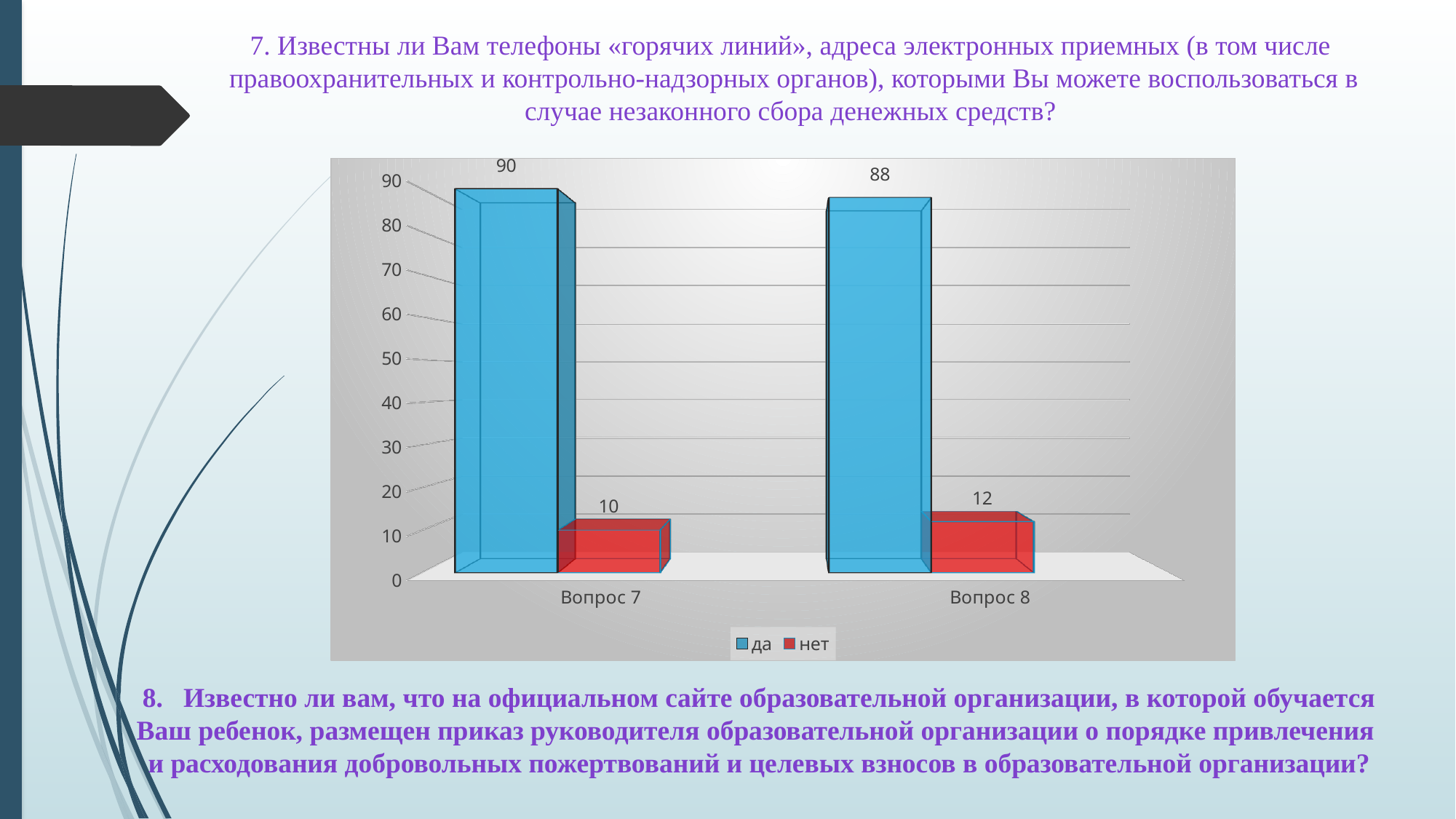
What is the value for "да" for Вопрос 8? 88 Which category has the lowest value for "нет"? Вопрос 7 What kind of chart is shown on the slide? Bar chart Which is larger: "да" for Вопрос 8 or "нет" for Вопрос 8? да for Вопрос 8 What is the value for "нет" for Вопрос 8? 12 How many series does the legend list? 2 What is the difference between the "нет" values for Вопрос 8 and Вопрос 7? 2 What is the value for "нет" for Вопрос 7? 10 How many categories are shown on the x axis? 2 Which category has the highest value for "да"? Вопрос 7 What is the difference between the "да" and "нет" values for Вопрос 7? 80 What is the value for "да" for Вопрос 7? 90